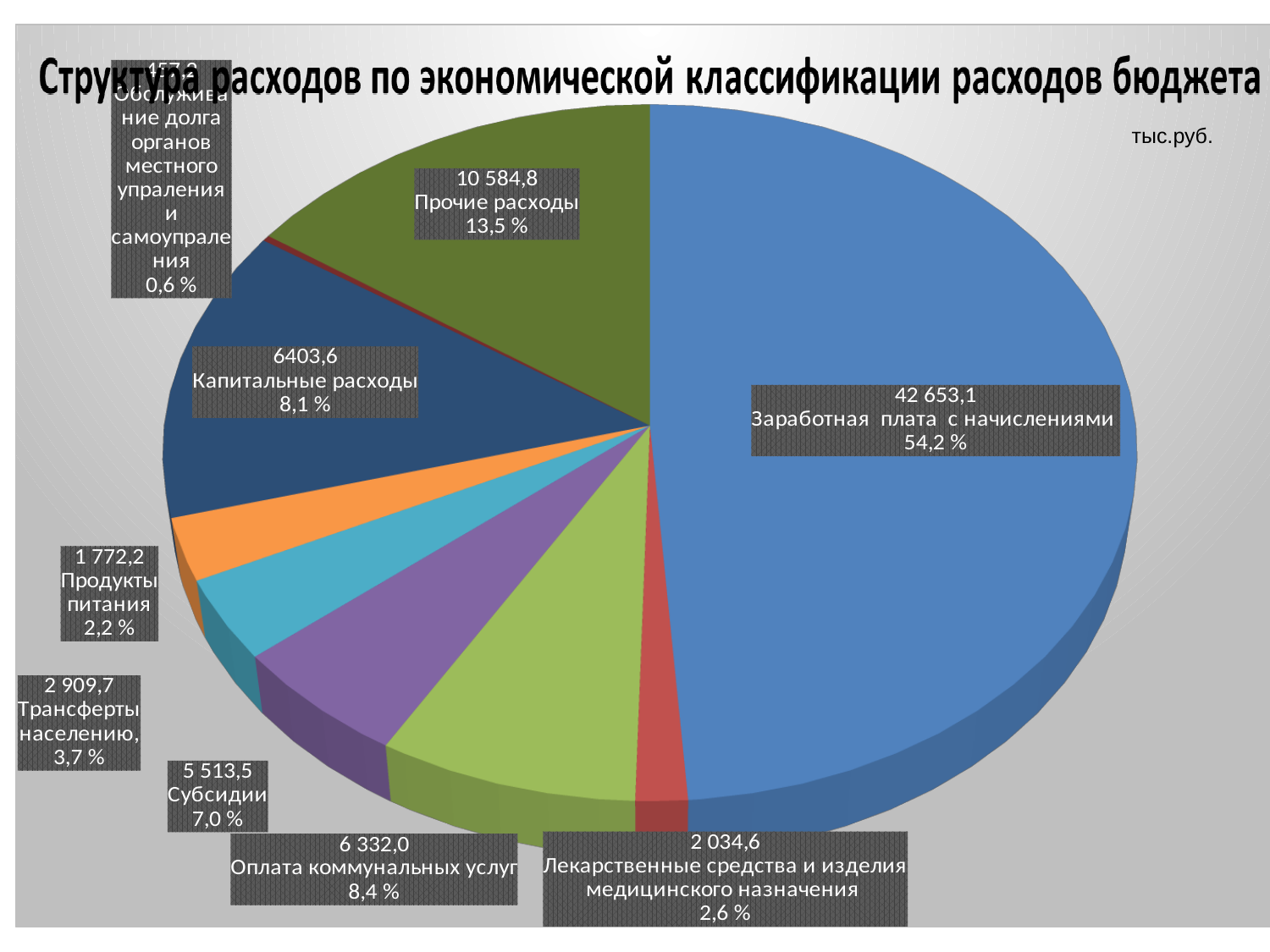
What unit is stated for the values on the chart? тыс.руб. What is the value for Лекарственные средства и изделия медицинского назначения? 2 034,6 Which is larger, the value for Трансферты населению or the value for Продукты питания? Трансферты населению What kind of chart is shown on the slide? pie chart What share of the pie does Прочие расходы take? 13,5 % Which category has the largest slice of the pie? Заработная плата с начислениями What is the value for Оплата коммунальных услуг? 6 332,0 Which category has the smallest slice of the pie? Обслуживание долга органов местного управления и самоуправления What is the value for Заработная плата с начислениями? 42 653,1 How many slices does the pie chart have? 9 What share of the pie does Субсидии take? 7,0 % What is the difference between the values for Капитальные расходы and Оплата коммунальных услуг? 71,6